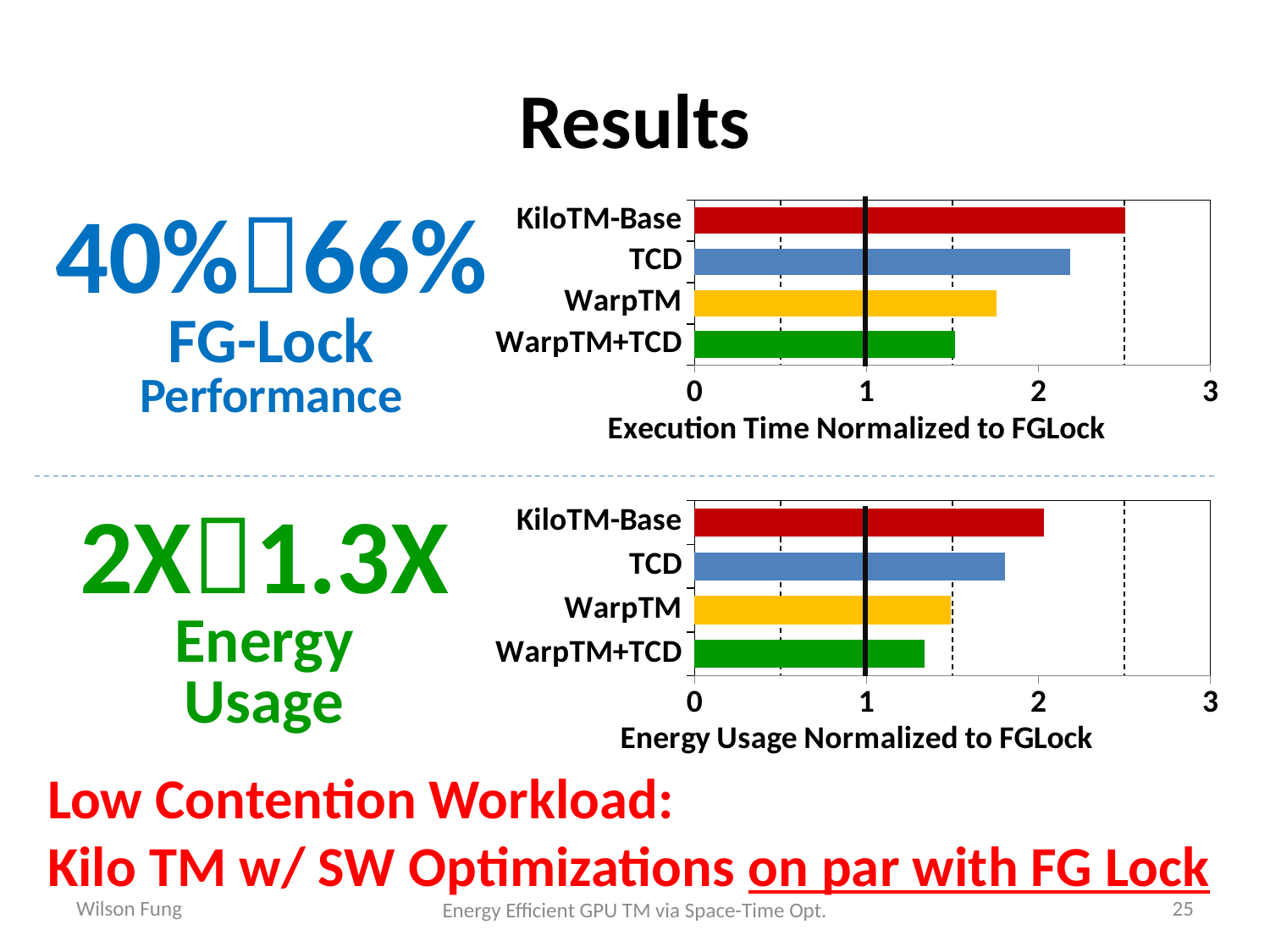
In the bottom chart (Energy Usage Normalized to FGLock), which category has the lowest value? WarpTM+TCD In the top chart (Execution Time Normalized to FGLock), which is larger, the value for TCD or the value for WarpTM? TCD In the bottom chart (Energy Usage Normalized to FGLock), which category has the highest value? KiloTM-Base In the bottom chart (Energy Usage Normalized to FGLock), is the value for WarpTM+TCD greater or less than 1? greater What kind of chart is the top chart (Execution Time Normalized to FGLock)? Bar chart What is the x-axis title of the bottom chart? Energy Usage Normalized to FGLock In the bottom chart (Energy Usage Normalized to FGLock), is the value for TCD greater or less than 2? less In the top chart (Execution Time Normalized to FGLock), is the value for WarpTM+TCD greater or less than 2? less In the top chart (Execution Time Normalized to FGLock), which category has the longest bar? KiloTM-Base In the top chart (Execution Time Normalized to FGLock), which category has the shortest bar? WarpTM+TCD How many categories are shown in the bottom chart (Energy Usage Normalized to FGLock)? 4